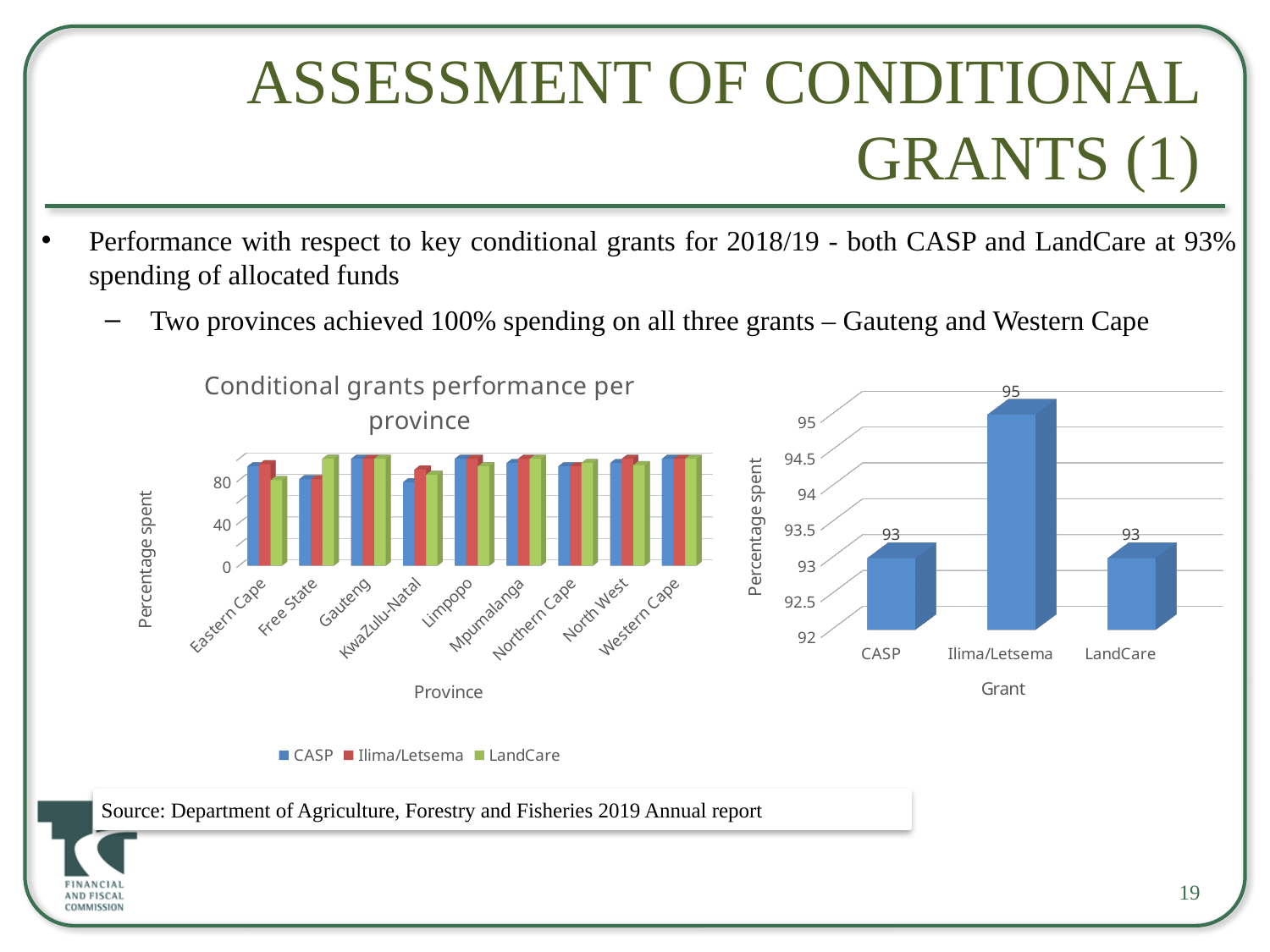
In the chart titled 'Conditional grants performance per province', how many provinces are shown on the x axis? 9 What kind of chart is the chart titled 'Conditional grants performance per province'? Bar chart In the right-hand chart, which grant has the highest percentage spent? Ilima/Letsema In the chart titled 'Conditional grants performance per province', how many series does the legend list? 3 In the chart titled 'Conditional grants performance per province', is the CASP value for Gauteng greater or less than 80? greater In the right-hand chart, is the value for Ilima/Letsema larger than the value for LandCare? Yes In the right-hand chart, what is the value for CASP? 93 In the right-hand chart, what is the difference between the values for Ilima/Letsema and CASP? 2 In the right-hand chart, how many grants are shown on the x axis? 3 In the right-hand chart, what is the value for LandCare? 93 In the right-hand chart, what is the value for Ilima/Letsema? 95